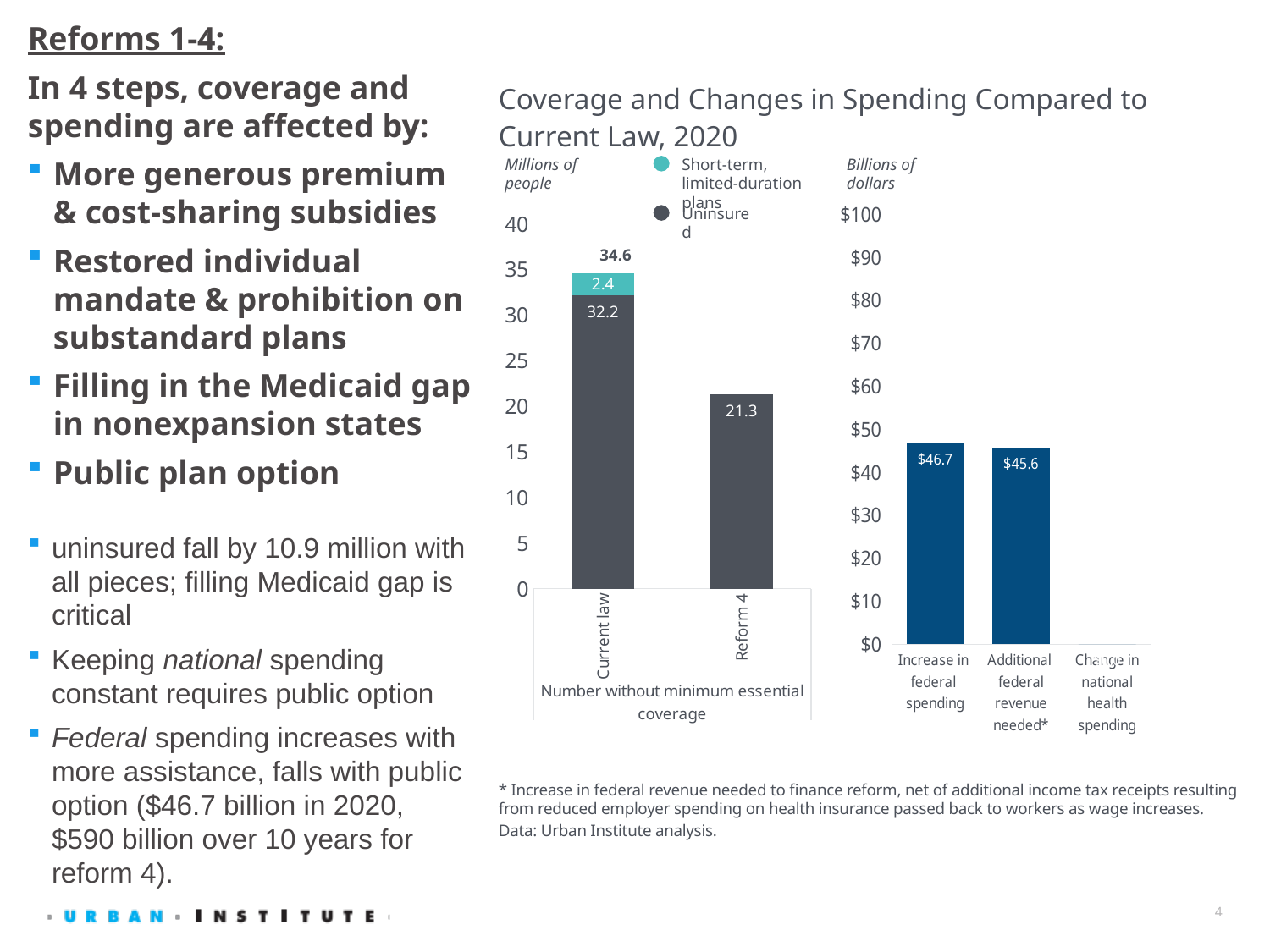
In the right chart (Billions of dollars), how many categories are shown on the x axis? 3 In the left chart (Millions of people), which category has the taller bar, Current law or Reform 4? Current law In the left chart (Millions of people), what is the difference between the Uninsured value under Current law and the value under Reform 4? 10.9 In the left chart (Millions of people), what is the total of the stacked bar for Current law? 34.6 In the right chart (Billions of dollars), what is the value for Increase in federal spending? $46.7 In the left chart (Millions of people), what is the value for Reform 4? 21.3 In the left chart (Millions of people), how many series does the legend list? 2 In the left chart (Millions of people), what is the value for Short-term, limited-duration plans under Current law? 2.4 In the right chart (Billions of dollars), what is the value for Additional federal revenue needed*? $45.6 In the right chart (Billions of dollars), what is the difference between Increase in federal spending and Additional federal revenue needed*? $1.1 What type of chart is the right chart (Billions of dollars)? Bar chart In the left chart (Millions of people), what is the value for Uninsured under Current law? 32.2